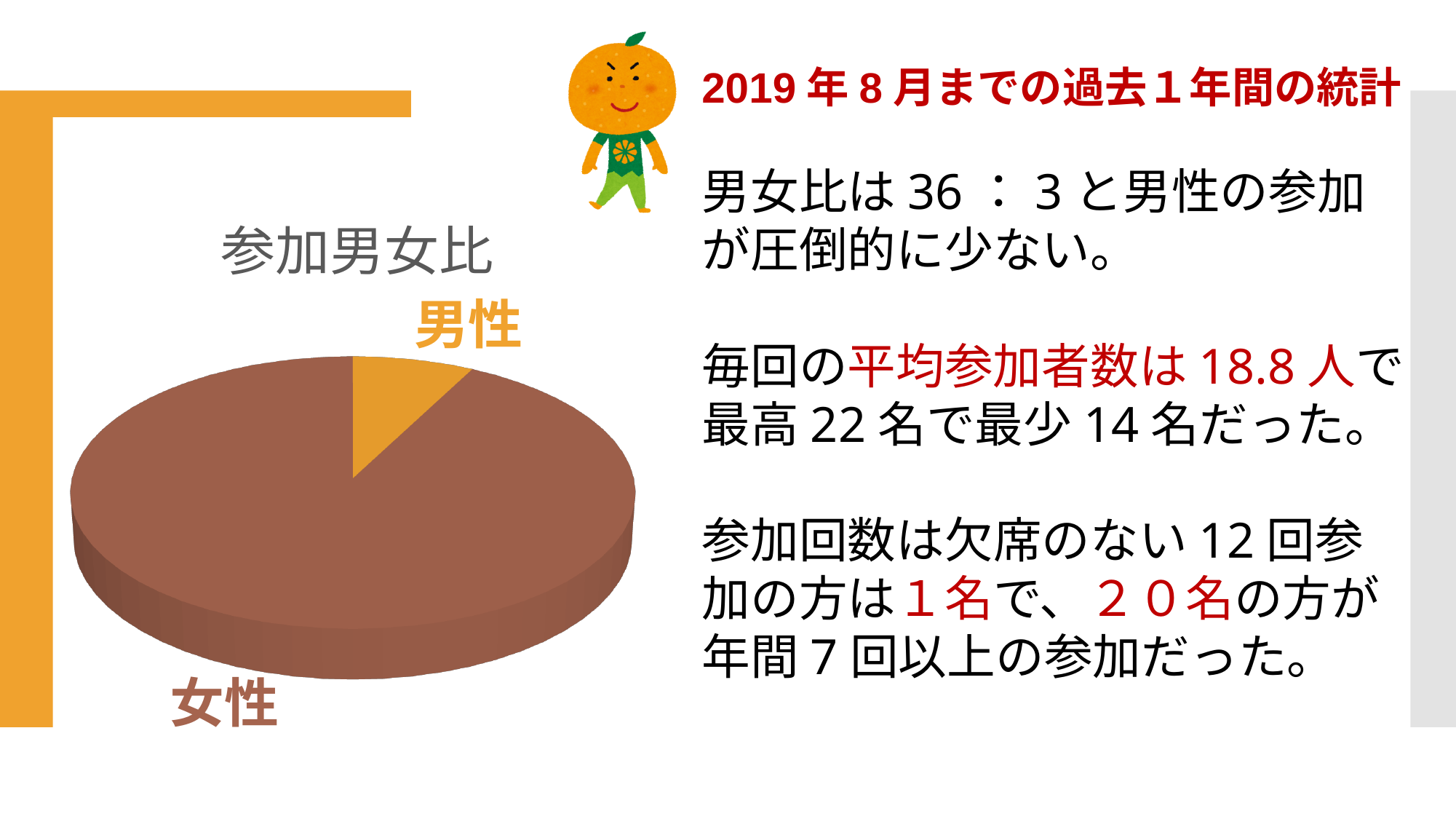
Is the 女性 slice more or less than half of the pie chart? more What is the title of the pie chart? 参加男女比 How many slices does the pie chart have? 2 Which category has the smallest slice in the pie chart? 男性 What kind of chart is shown on the slide? pie chart Which category has the largest slice in the pie chart? 女性 Is the 男性 slice more or less than a quarter of the pie chart? less What colour is the 男性 slice in the pie chart? orange Which slice is larger in the pie chart, 男性 or 女性? 女性